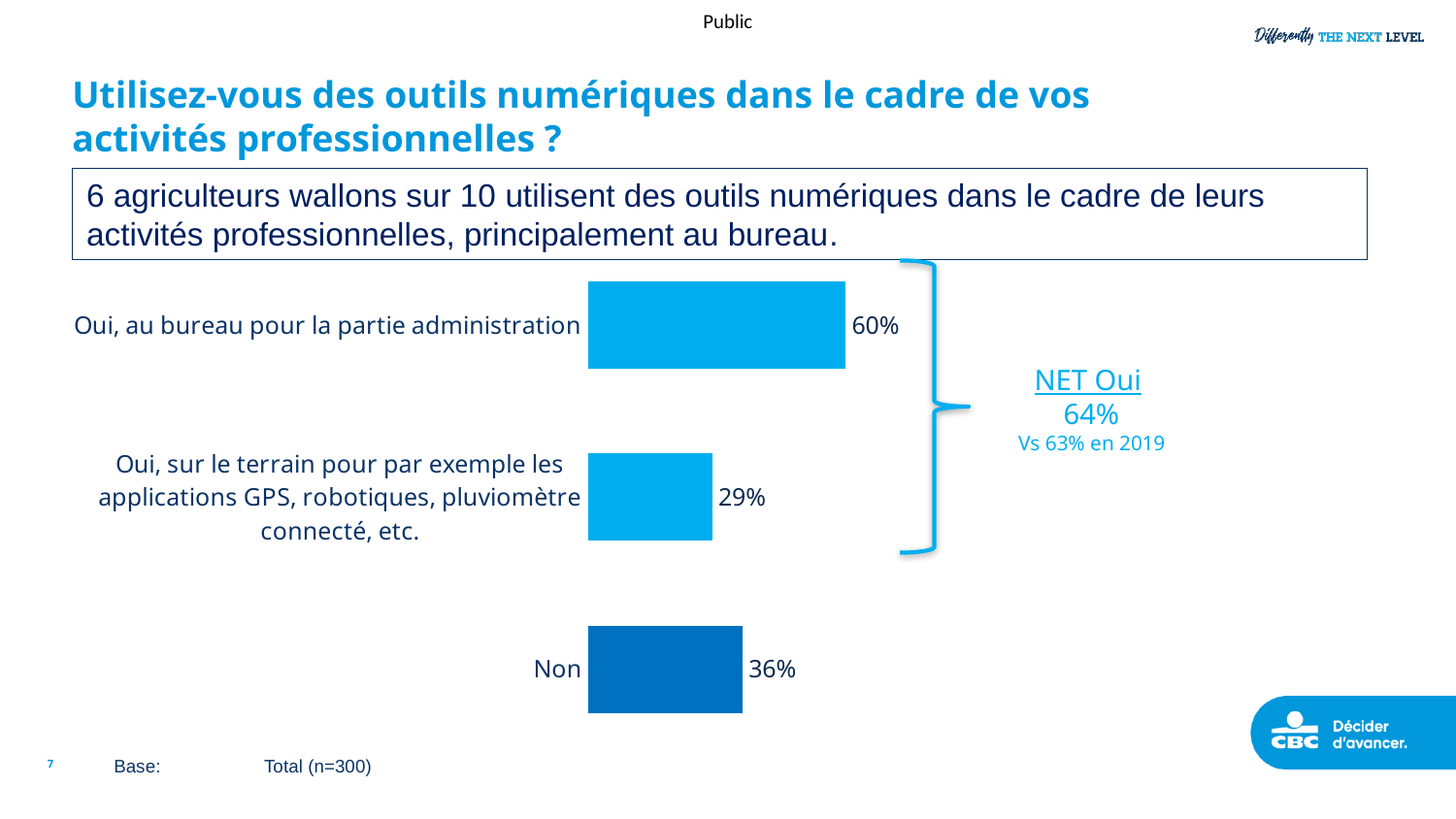
What is the value for "Non"? 36% What is the difference between the value for "Non" and the value for "Oui, sur le terrain"? 7% What is the value for "Oui, sur le terrain pour par exemple les applications GPS, robotiques, pluviomètre connecté, etc."? 29% Which is larger: the value for "Non" or the value for "Oui, sur le terrain"? Non What is the value for "Oui, au bureau pour la partie administration"? 60% What kind of chart is shown on the slide? Bar chart What is the difference between the value for "Oui, au bureau pour la partie administration" and the value for "Non"? 24% What is the "NET Oui" value shown next to the chart? 64% Which category has the highest value? Oui, au bureau pour la partie administration How many categories are shown in the chart? 3 Which category has the lowest value? Oui, sur le terrain pour par exemple les applications GPS, robotiques, pluviomètre connecté, etc. What was the "NET Oui" value in 2019, as shown on the slide? 63%